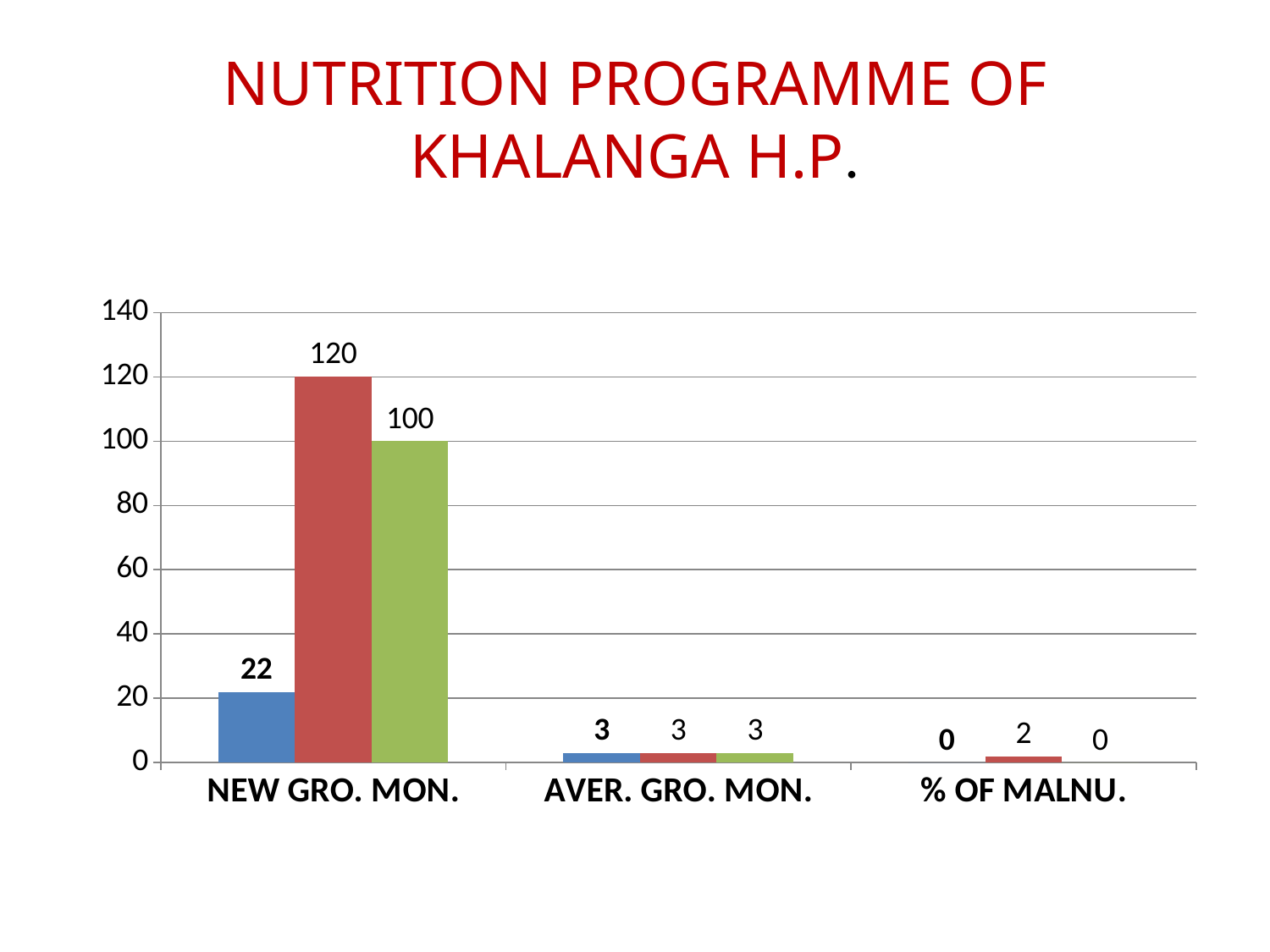
How many categories are shown on the x axis? 3 What is the value of the green bar for AVER. GRO. MON.? 3 What is the title of the slide? NUTRITION PROGRAMME OF KHALANGA H.P. What is the value of the green bar for NEW GRO. MON.? 100 What is the value of the red bar for NEW GRO. MON.? 120 What is the value of the blue bar for NEW GRO. MON.? 22 What is the value of the red bar for % OF MALNU.? 2 What is the difference between the red bar and the green bar for NEW GRO. MON.? 20 What is the difference between the red bar and the blue bar for NEW GRO. MON.? 98 What type of chart is shown on the slide? bar chart Which is larger for NEW GRO. MON., the blue bar or the green bar? the green bar Which category has the highest bar in the chart? NEW GRO. MON.